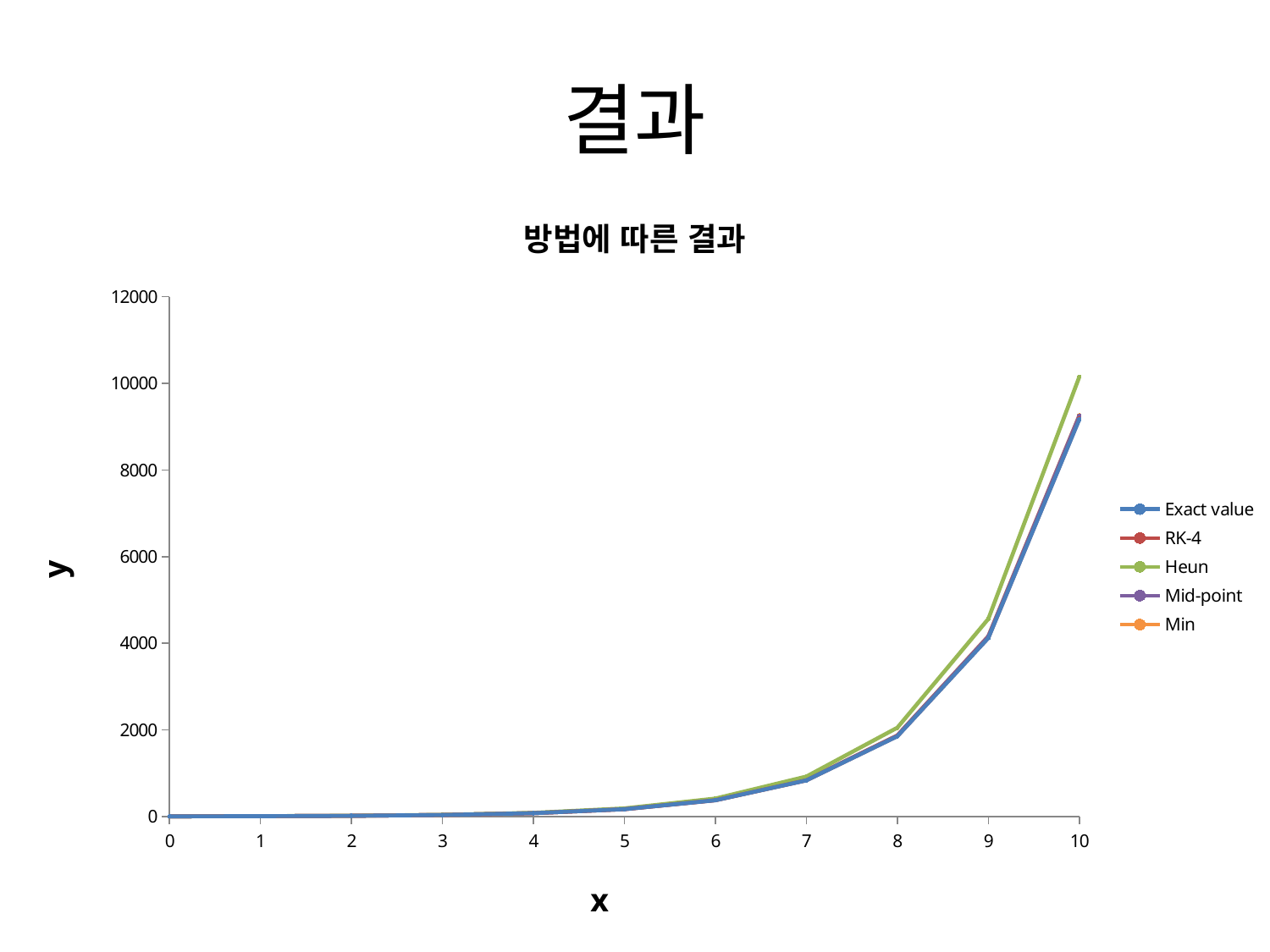
At x = 10, which is larger, the Heun value or the RK-4 value? Heun Is the value of the Exact value series at x = 7 greater or less than 2000? less Do the values of the Exact value series rise or fall as x increases from 0 to 10? rise Is the value of the Exact value series at x = 10 greater or less than 10000? less Which series has the highest value at x = 10? Heun Is the value of the Heun series at x = 9 greater or less than 4000? greater What kind of chart is shown on the slide? line chart What are the labels of the x axis and y axis? x and y What is the title of the chart? 방법에 따른 결과 How many series does the legend list? 5 How many x-axis tick values are shown on the chart? 11